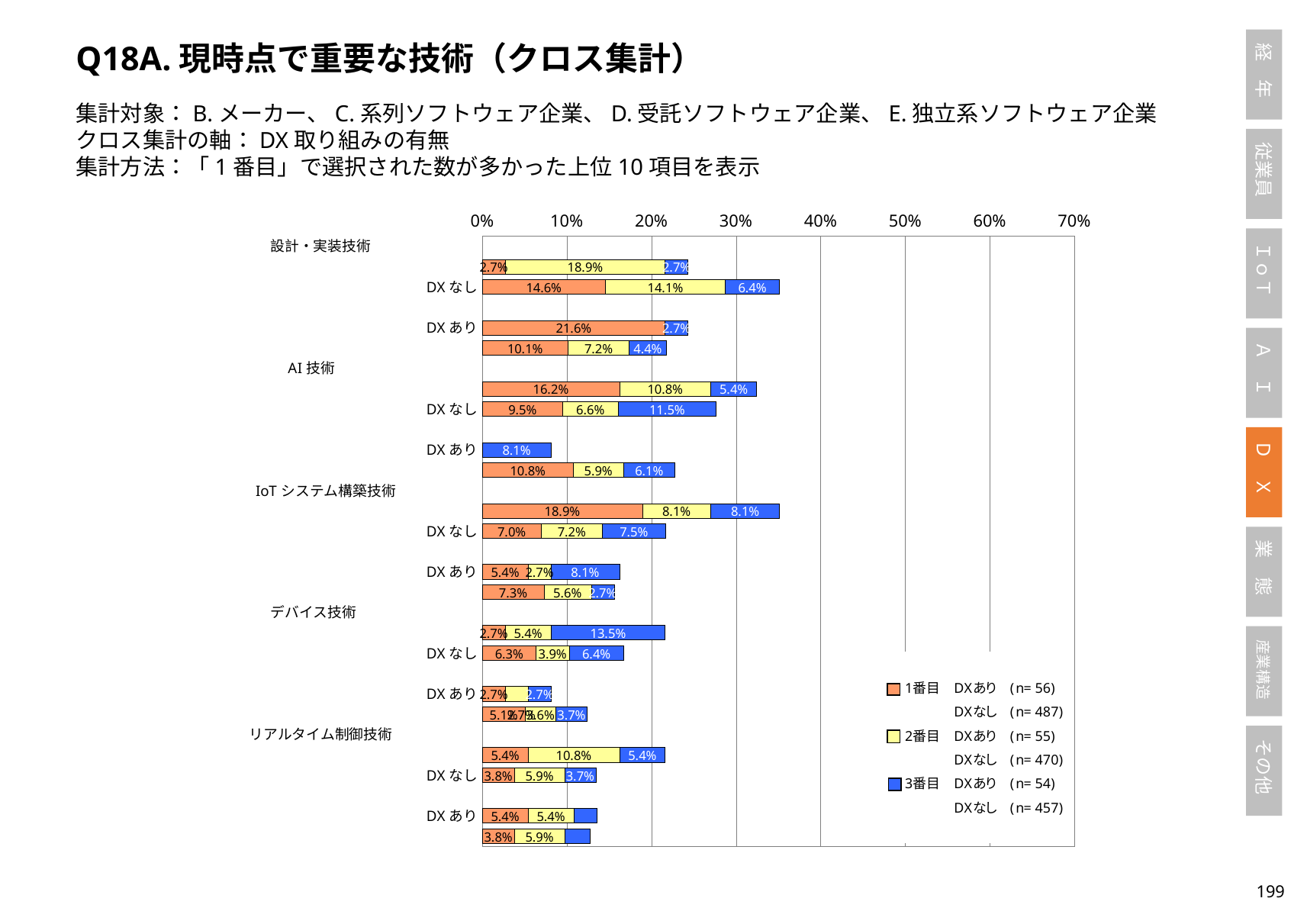
Which colour represents 3番目 in the legend? Blue What is the total of the bar with segments 14.6%, 14.1% and 6.4%? 35.1% In the bar whose first (orange) segment is 21.6%, what is the value of the blue (3番目) segment? 2.7% What kind of chart is shown on the slide? Stacked horizontal bar chart How many series does the legend list (1番目, 2番目, 3番目)? 3 According to the legend, what is the n for 3番目 DXなし? n= 457 What is the highest value shown on the horizontal axis? 70% According to the legend, what is the n for 2番目 DXなし? n= 470 What is the largest single segment value labeled anywhere on the chart? 21.6% According to the legend, what is the n for 1番目 DXあり? n= 56 In the bar with segments 14.6%, 14.1% and 6.4%, what is the difference between the 1番目 and 2番目 segments? 0.5% What is the total of the bar with segments 16.2%, 10.8% and 5.4%? 32.4%